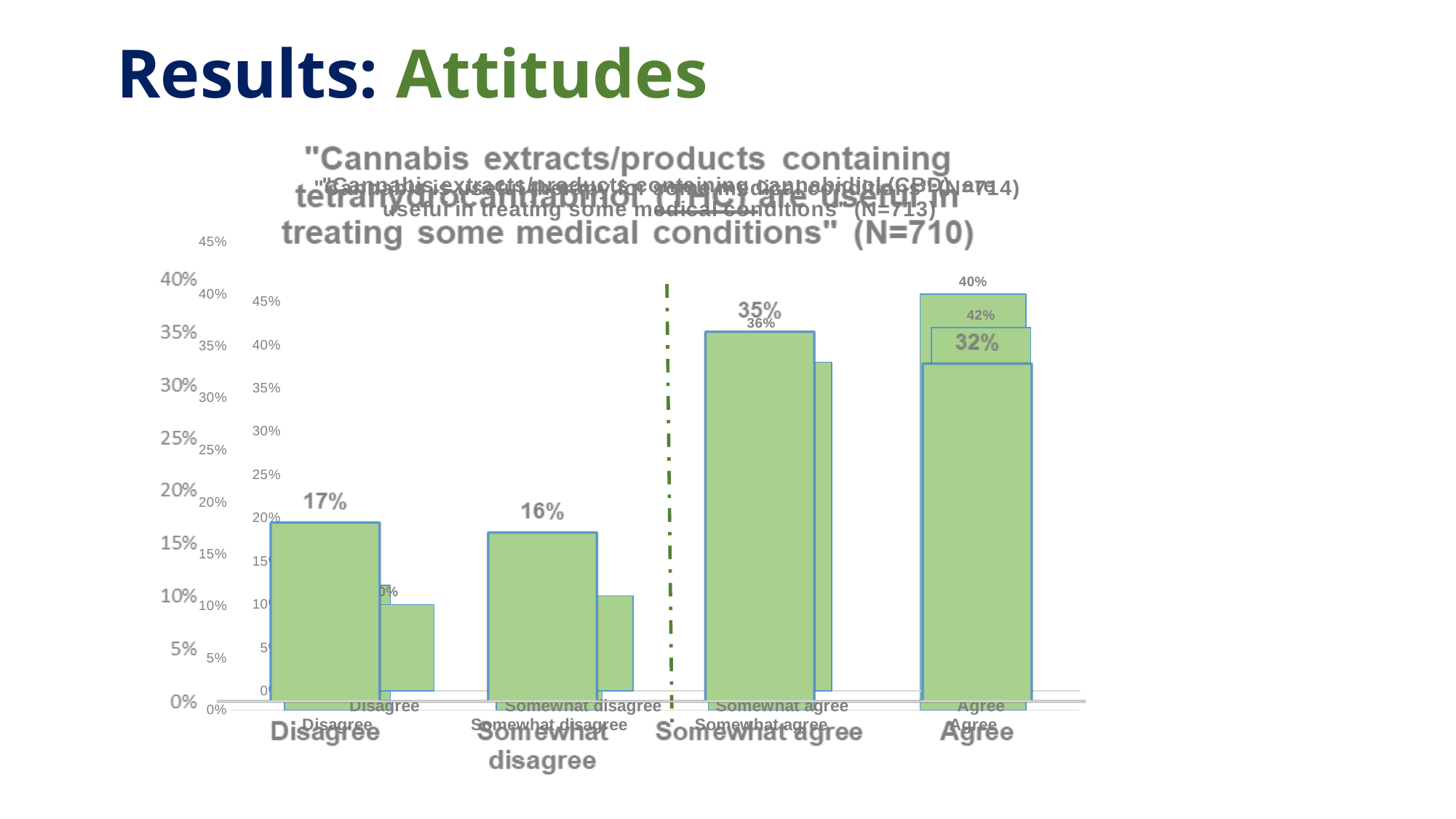
In the chart about THC products (N=710), what is the value for Disagree? 17% In the chart about THC products (N=710), what is the difference between Disagree and Somewhat disagree? 1% In the chart about THC products (N=710), is the value for Agree greater or less than 30%? greater In the chart about THC products (N=710), which category has the highest value? Somewhat agree In the chart about THC products (N=710), which is larger, Somewhat agree or Disagree? Somewhat agree In the chart about THC products (N=710), what is the difference between Somewhat agree and Agree? 3% In the chart about THC products (N=710), what is the value for Agree? 32% In the chart about THC products (N=710), what is the value for Somewhat agree? 35% What kind of chart is the chart about THC products (N=710)? Bar chart In the chart about THC products (N=710), what is the value for Somewhat disagree? 16% What sample size (N) is given in the title of the chart about THC products? N=710 In the chart about THC products (N=710), how many response categories are shown on the x axis? 4